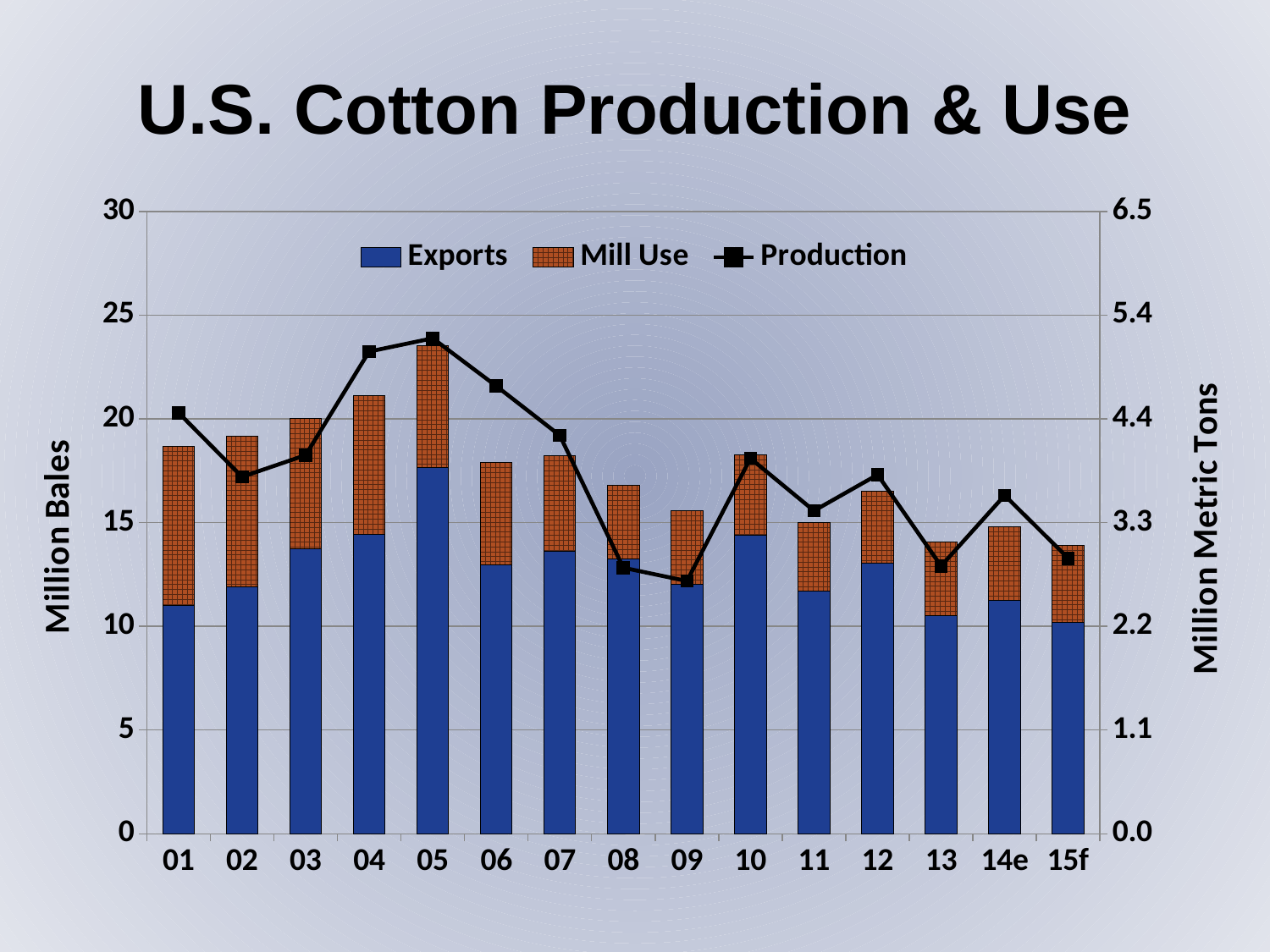
How many series does the legend list? 3 Which is larger, the Production value for 04 or for 08? 04 What kind of chart is this? stacked bar chart with a line Which year has the tallest stacked bar (Exports plus Mill Use)? 05 Does the Production line rise or fall from 05 to 09? fall Which year has the lowest Production value? 09 Which year has the highest Production value? 05 Is the Exports value for 05 greater or less than 15 million bales? greater How many years (categories) are shown on the x axis? 15 Is the Production value for 05 greater or less than 20 million bales? greater What is the title of the chart? U.S. Cotton Production & Use Is the Production value for 09 greater or less than 15 million bales? less